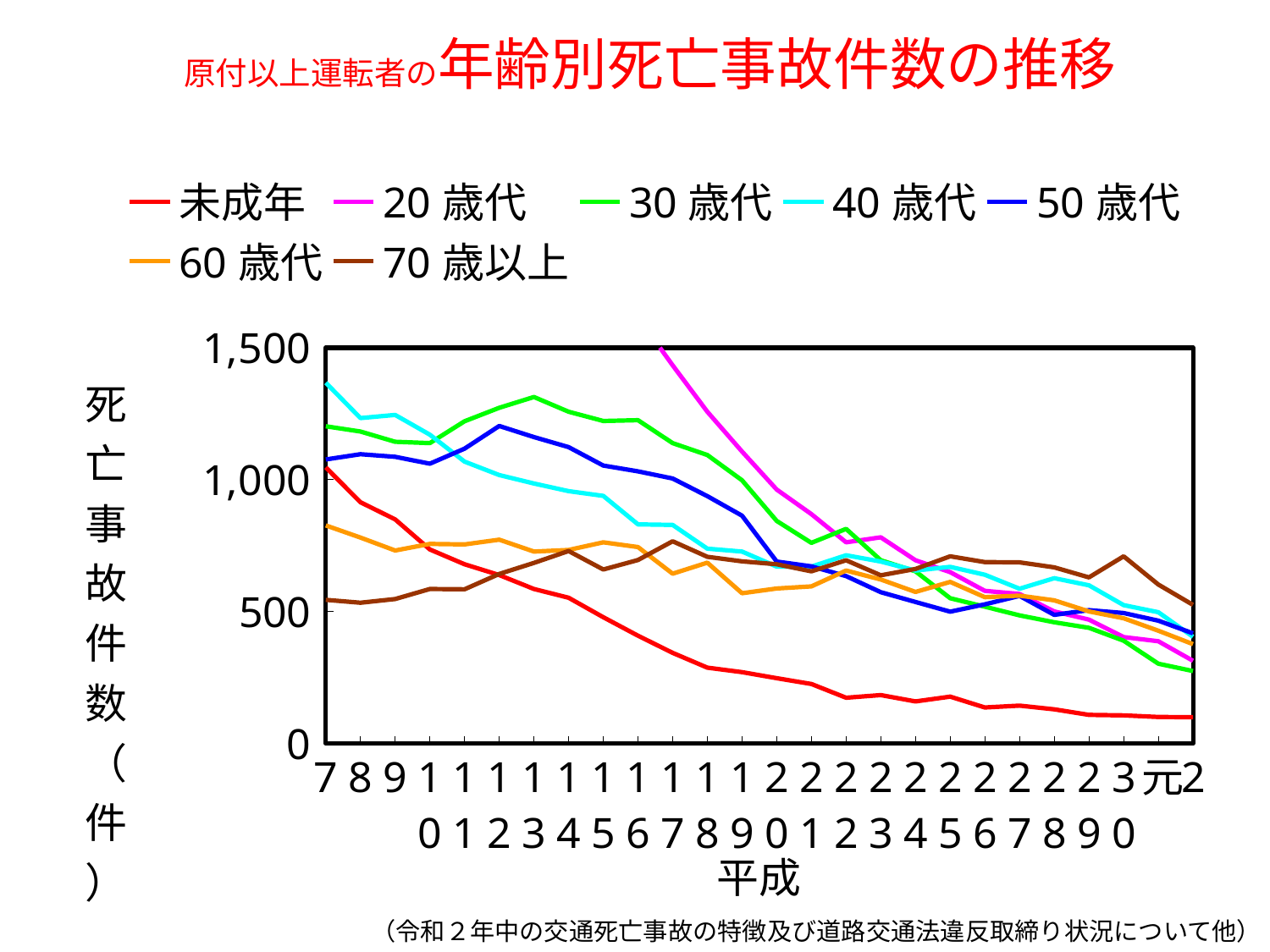
In 平成7, which is larger: 未成年 or 70歳以上? 未成年 Is the value for 40歳代 in 平成7 greater or less than 1,000? greater Is the value for 未成年 in 令和2 greater or less than 500? less Which series has the lowest value in 令和2? 未成年 What is the label on the y axis? 死亡事故件数（件） What kind of chart is shown on the slide? line chart Does the value for 30歳代 rise or fall from 平成7 to 令和2? fall How many points are labelled along the x axis? 26 Is the value for 30歳代 in 平成13 greater or less than 1,000? greater Does the value for 未成年 rise or fall from 平成7 to 令和2? fall How many series does the legend list? 7